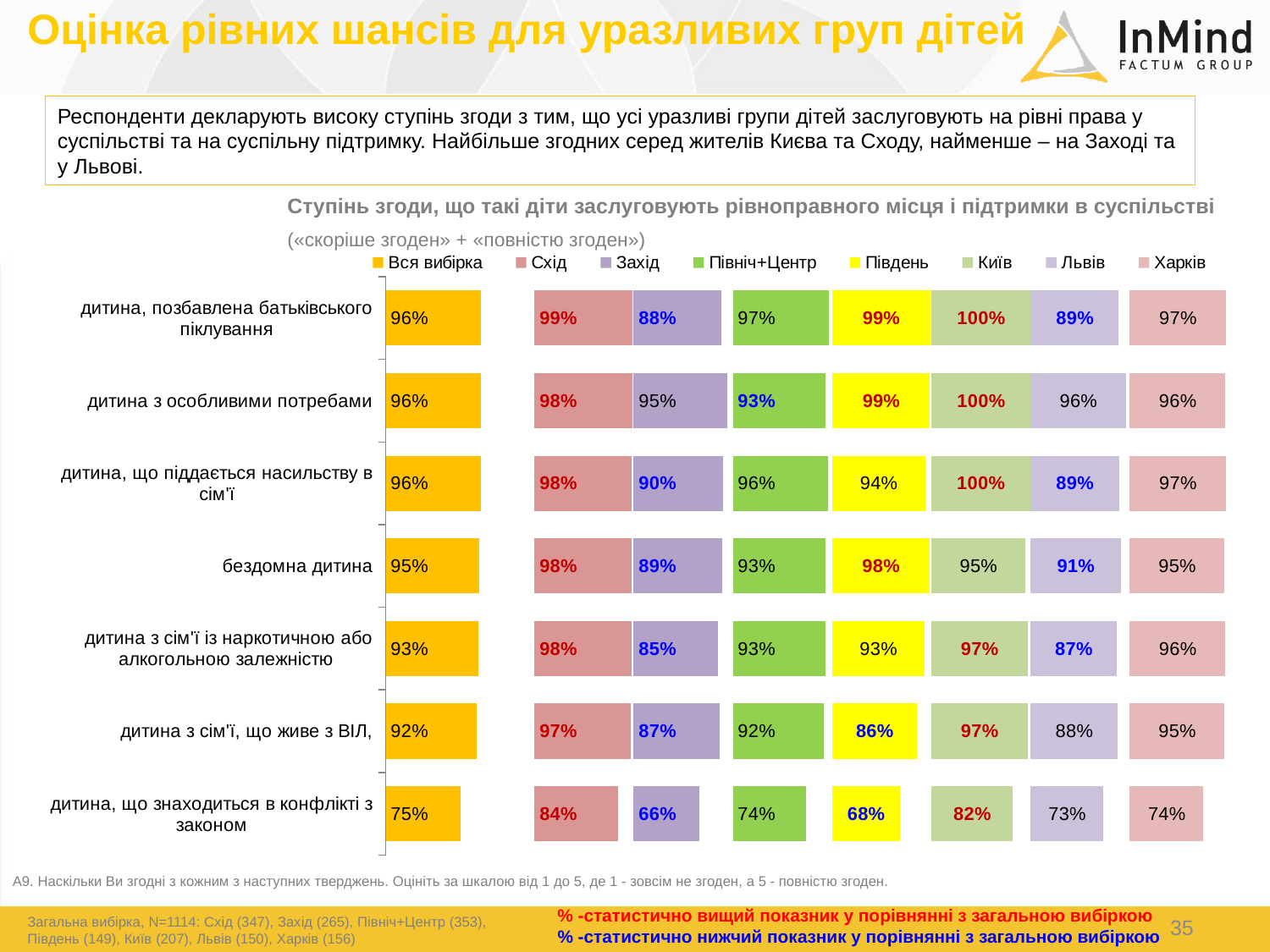
How many series does the legend list? 8 What is the value for «Вся вибірка» for the category «дитина, що знаходиться в конфлікті з законом»? 75% What is the difference in «Вся вибірка» between «дитина з сім'ї, що живе з ВІЛ» and «дитина, що знаходиться в конфлікті з законом»? 17 percentage points Which category has the lowest value for «Вся вибірка»? дитина, що знаходиться в конфлікті з законом What is the difference between «Схід» and «Захід» for the category «дитина, що знаходиться в конфлікті з законом»? 18 percentage points How many categories are shown in the chart? 7 What kind of chart is shown on the slide? Bar chart For the category «дитина з сім'ї, що живе з ВІЛ», which is larger: «Львів» or «Харків»? Харків What is the value for «Захід» for the category «бездомна дитина»? 89% What is the value for «Київ» for the category «дитина з особливими потребами»? 100% For the category «дитина, що знаходиться в конфлікті з законом», which series has the highest value? Схід For the category «дитина, що знаходиться в конфлікті з законом», which series has the lowest value? Захід